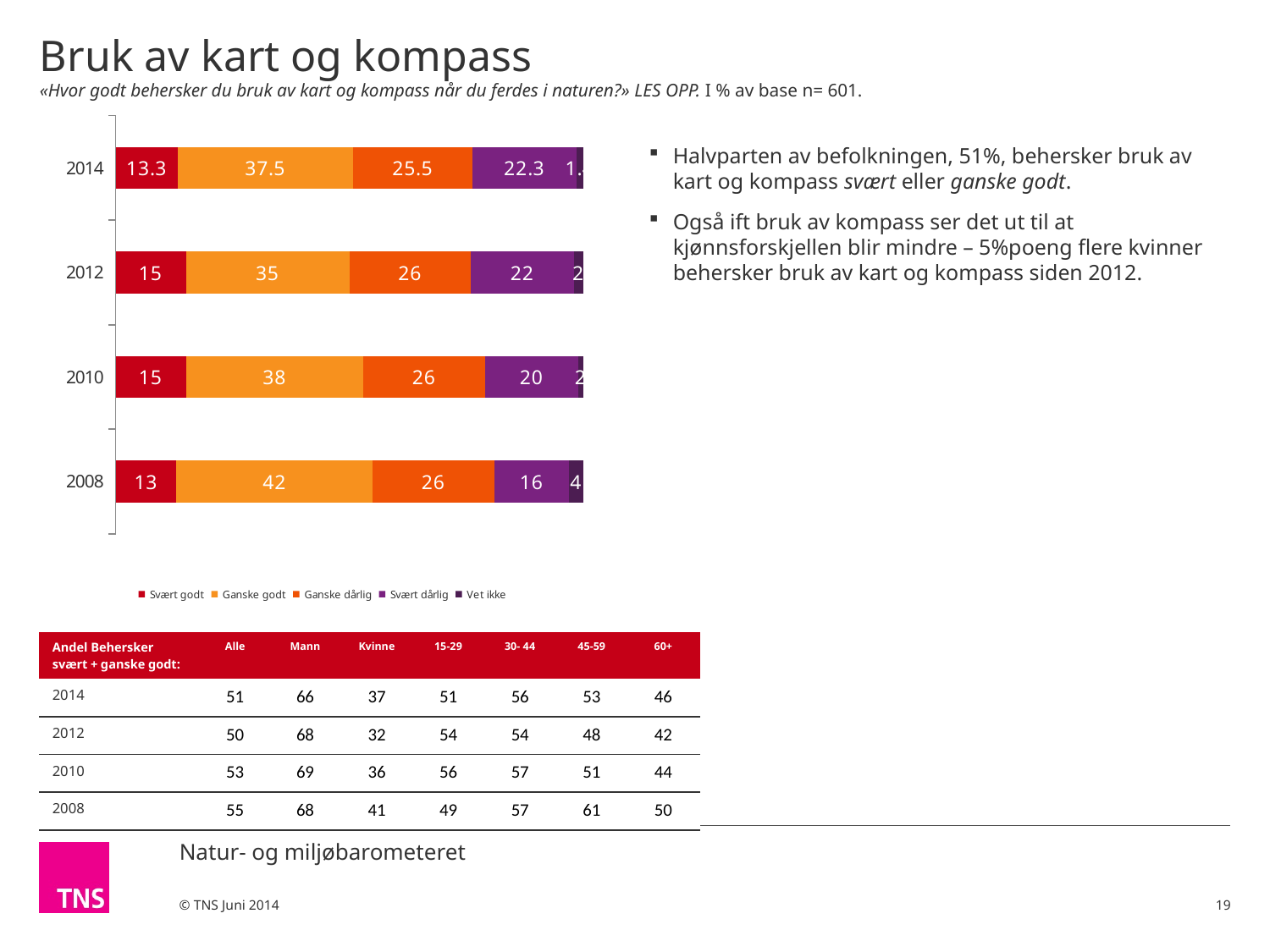
Does the Svært dårlig value rise or fall from 2008 to 2014? Rise Which year has the larger Svært godt value, 2012 or 2008? 2012 What is the value for Ganske dårlig in 2014? 25.5 What is the value for Svært dårlig in 2012? 22 How many series does the legend list? 5 How many years are shown in the chart? 4 What kind of chart is shown on the slide? Stacked bar chart What is the difference between the Ganske godt values for 2010 and 2012? 3 What is the value for Ganske godt in 2008? 42 What is the value for Svært godt in 2014? 13.3 Which year has the lowest value for Svært dårlig? 2008 Which year has the highest value for Ganske godt? 2008